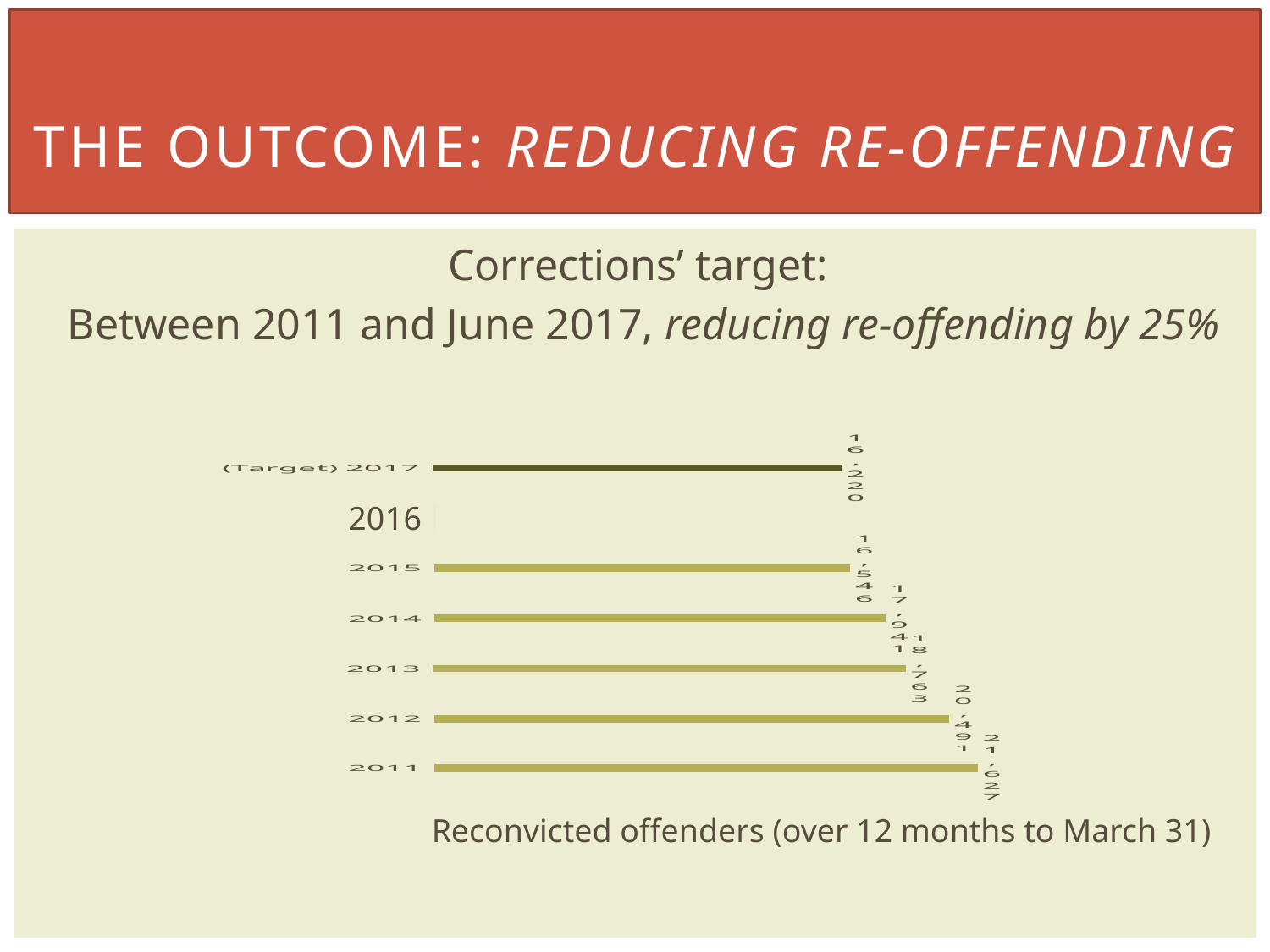
What is the value for 2015? 16,546 What kind of chart is shown on the slide? Bar chart Which year has the highest value? 2011 What is the difference between the values for 2015 and (Target) 2017? 326 What is the value for 2014? 17,941 Which is larger, the value for 2013 or the value for 2014? 2013 What is the value for 2012? 20,491 What is the value for 2011? 21,627 What is the value for (Target) 2017? 16,220 What is the difference between the values for 2011 and 2012? 1,136 What is the value for 2013? 18,763 Do the values fall or rise from 2011 to 2015? Fall